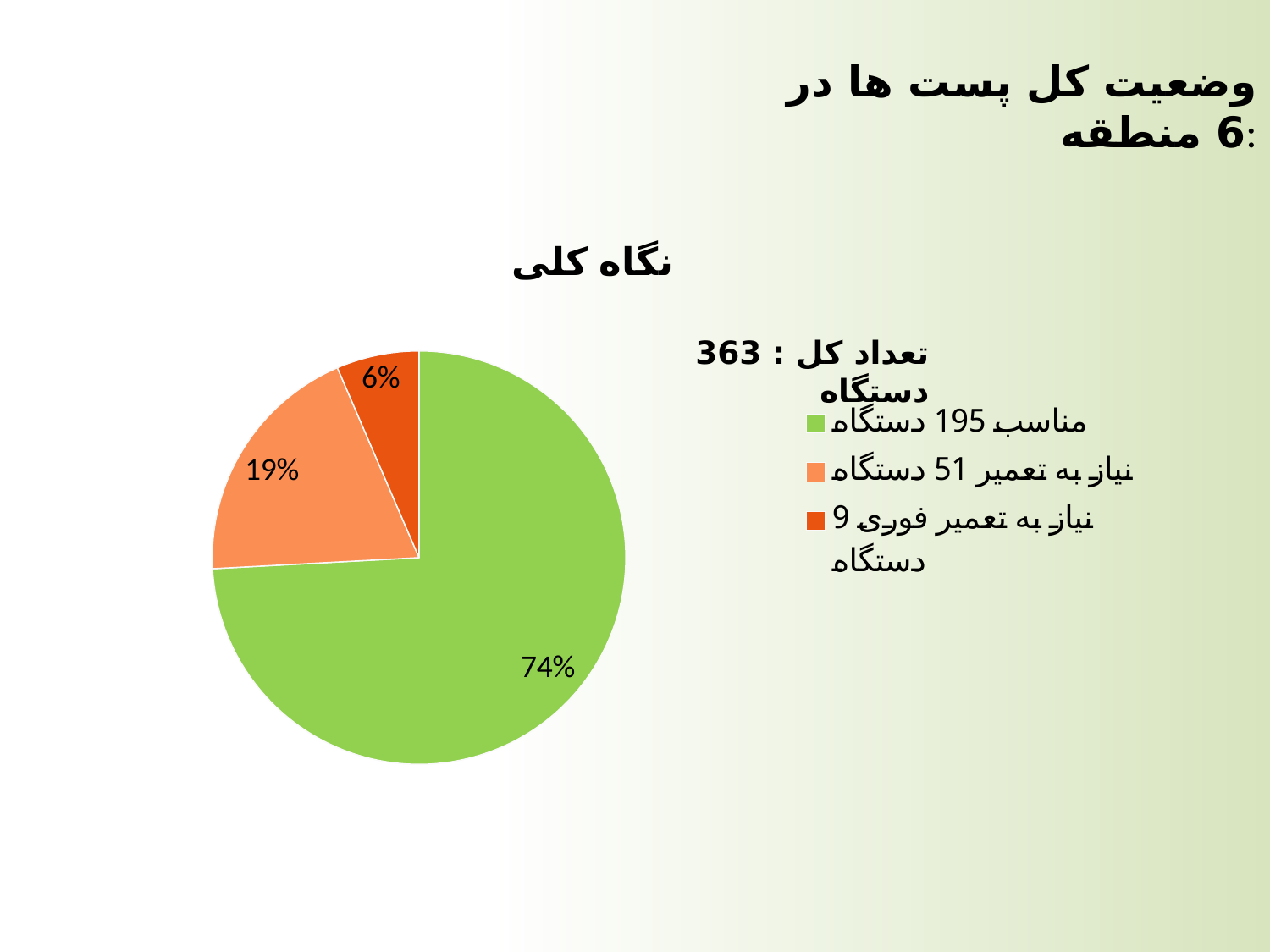
How many devices does the legend list for 'مناسب'? 195 دستگاه What percentage is shown for the 'مناسب' slice? 74% How many slices does the pie chart have? 3 Which colour represents 'نیاز به تعمیر' in the legend? light orange Which category has the smallest share of the pie? نیاز به تعمیر فوری Which category has the largest share of the pie? مناسب How many devices does the legend list for 'نیاز به تعمیر فوری'? 9 دستگاه What percentage is shown for the 'نیاز به تعمیر' slice? 19% What kind of chart is shown on the slide? pie chart What percentage is shown for the 'نیاز به تعمیر فوری' slice? 6% What is the title of the chart? نگاه کلی What is the difference in percentage points between the 'مناسب' slice and the 'نیاز به تعمیر' slice? 55 percentage points